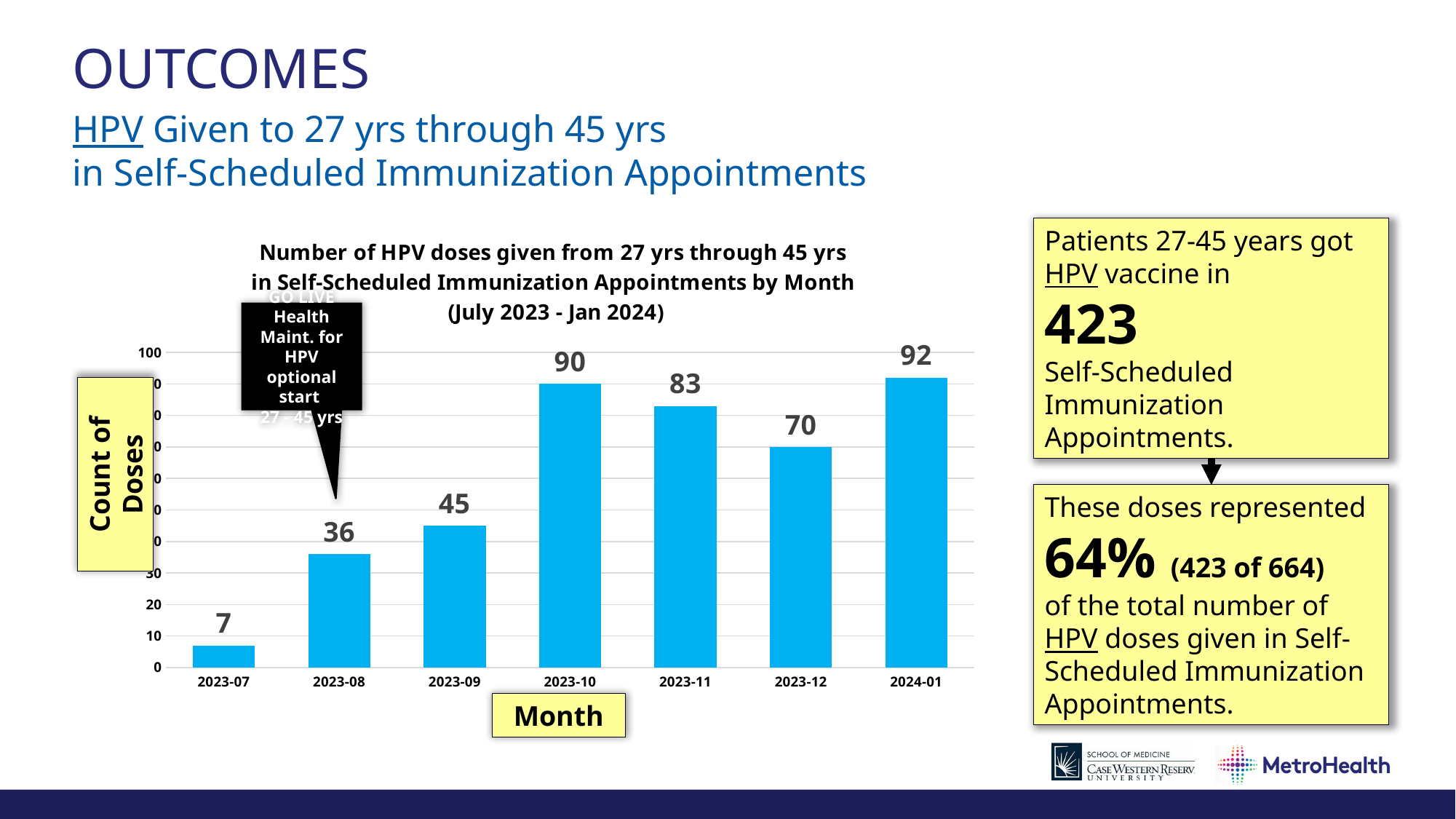
What is the count of doses for 2023-07? 7 What kind of chart is shown on the slide? bar chart How many months are shown on the x axis? 7 What is the difference in doses between 2024-01 and 2023-07? 85 Which month has the lowest count of doses? 2023-07 Which month has the highest count of doses? 2024-01 What is the label on the x axis of the chart? Month How many HPV doses were given in 2023-10? 90 Which month had more doses, 2023-09 or 2023-12? 2023-12 Is the value for 2023-08 greater or less than 50? less What is the difference in doses between 2023-10 and 2023-11? 7 How many doses were given in 2023-12? 70